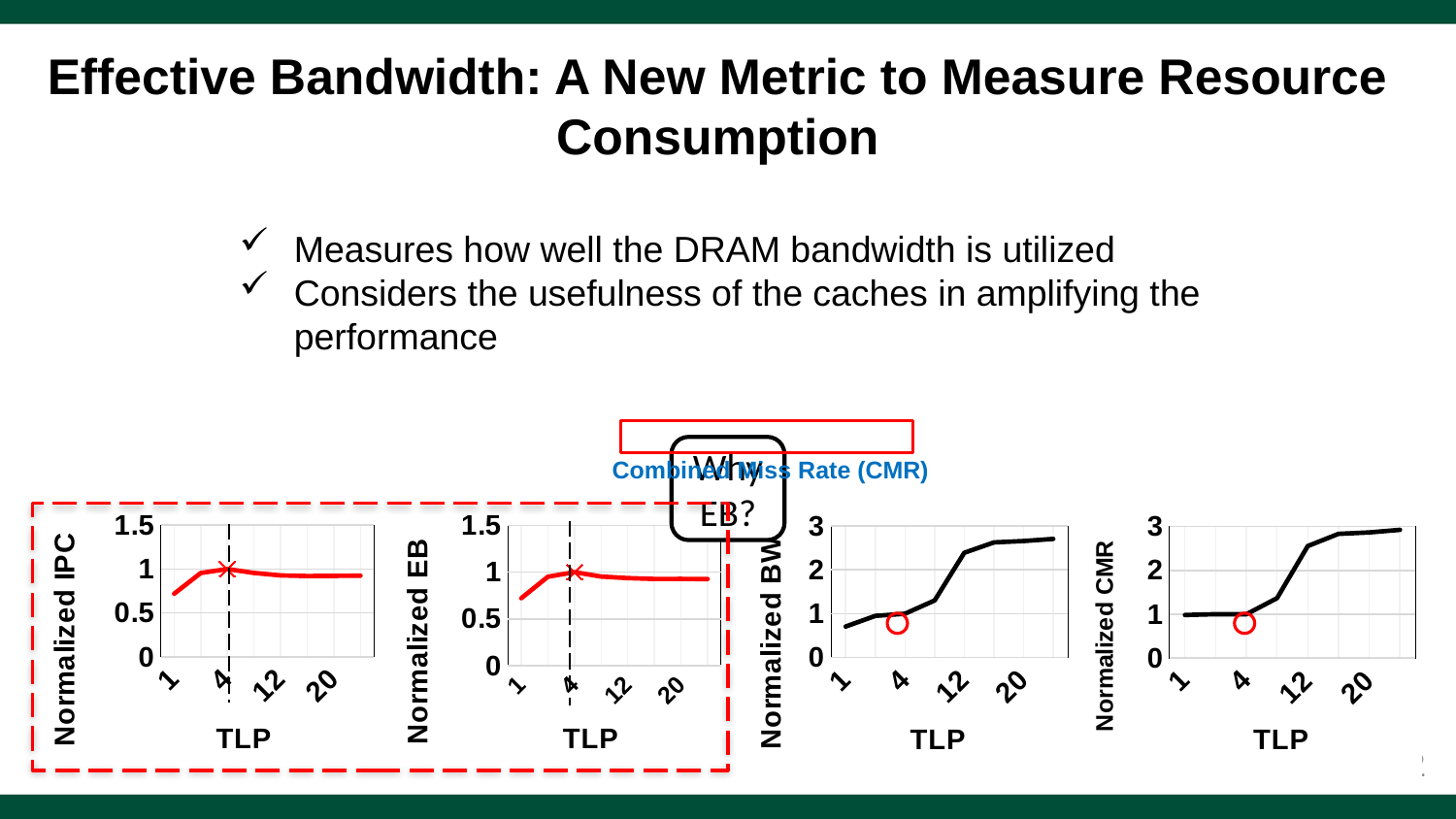
In the Normalized IPC chart, is the value at TLP 1 greater or less than 1? less What is the x-axis label of the Normalized EB chart? TLP In the Normalized BW chart, do the values rise or fall as TLP increases from 1 to 20? rise In the Normalized CMR chart, is the value at TLP 12 greater or less than 2? greater In the Normalized BW chart, is the value at TLP 20 greater or less than 2? greater In the Normalized CMR chart, do the values rise or fall as TLP increases from 4 to 20? rise What kind of chart is the Normalized IPC chart on the left of the slide? line chart What colour is the plotted line in the Normalized CMR chart? black How many TLP tick labels are shown on the x axis of the Normalized BW chart? 4 How many charts are plotted along the bottom of the slide? 4